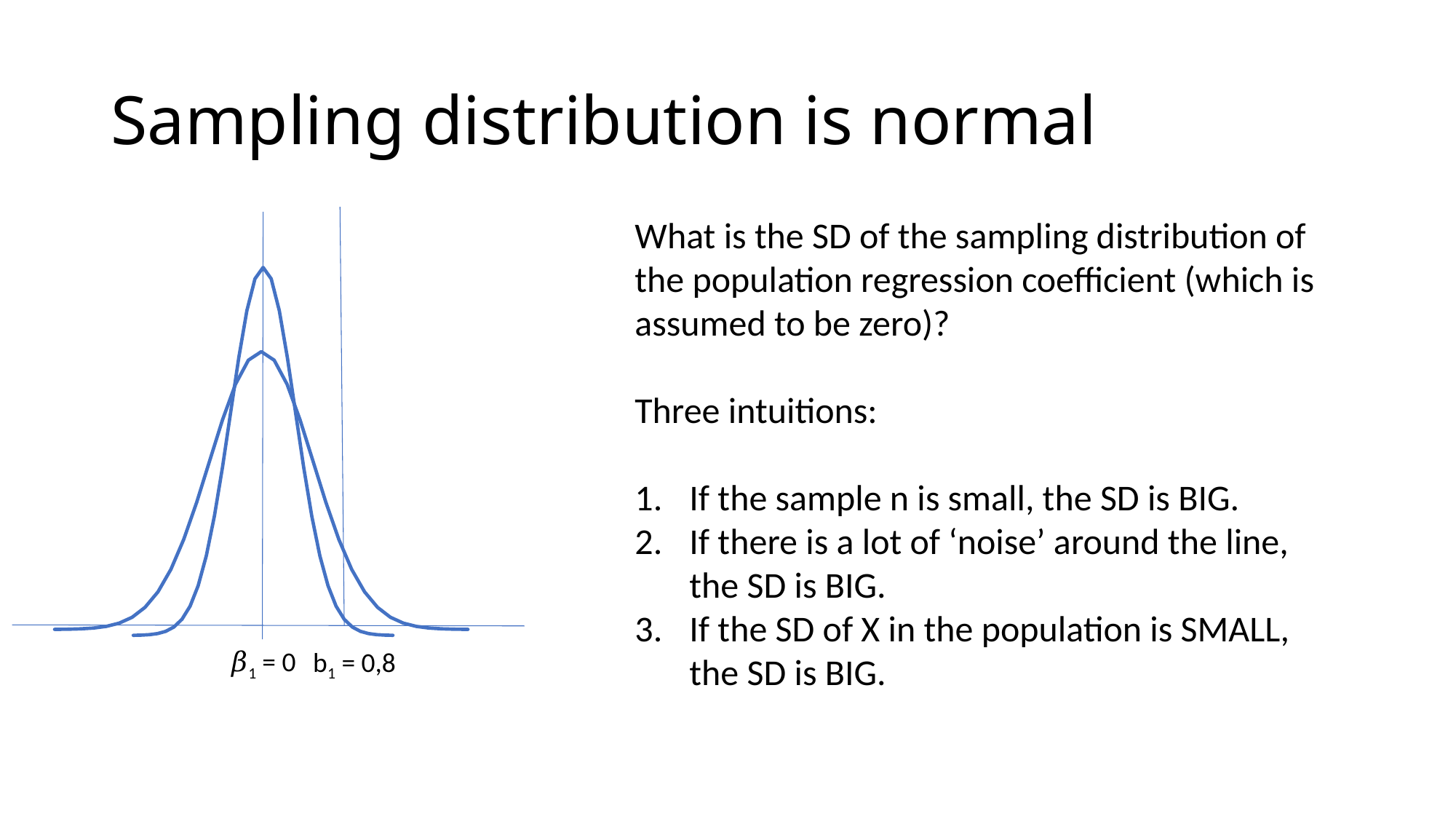
What value is labelled at the second vertical line to the right of the centre on the x axis? b1 = 0,8 What colour are the curves on the chart? blue What value is labelled at the centre of the two curves on the x axis? β1 = 0 How many curves are plotted on the chart? 2 What kind of chart is shown on the left of the slide? line chart Which curve reaches the higher peak, the narrower one or the wider one? the narrower one Do both curves peak at the same x position? yes Does the chart have a legend? no